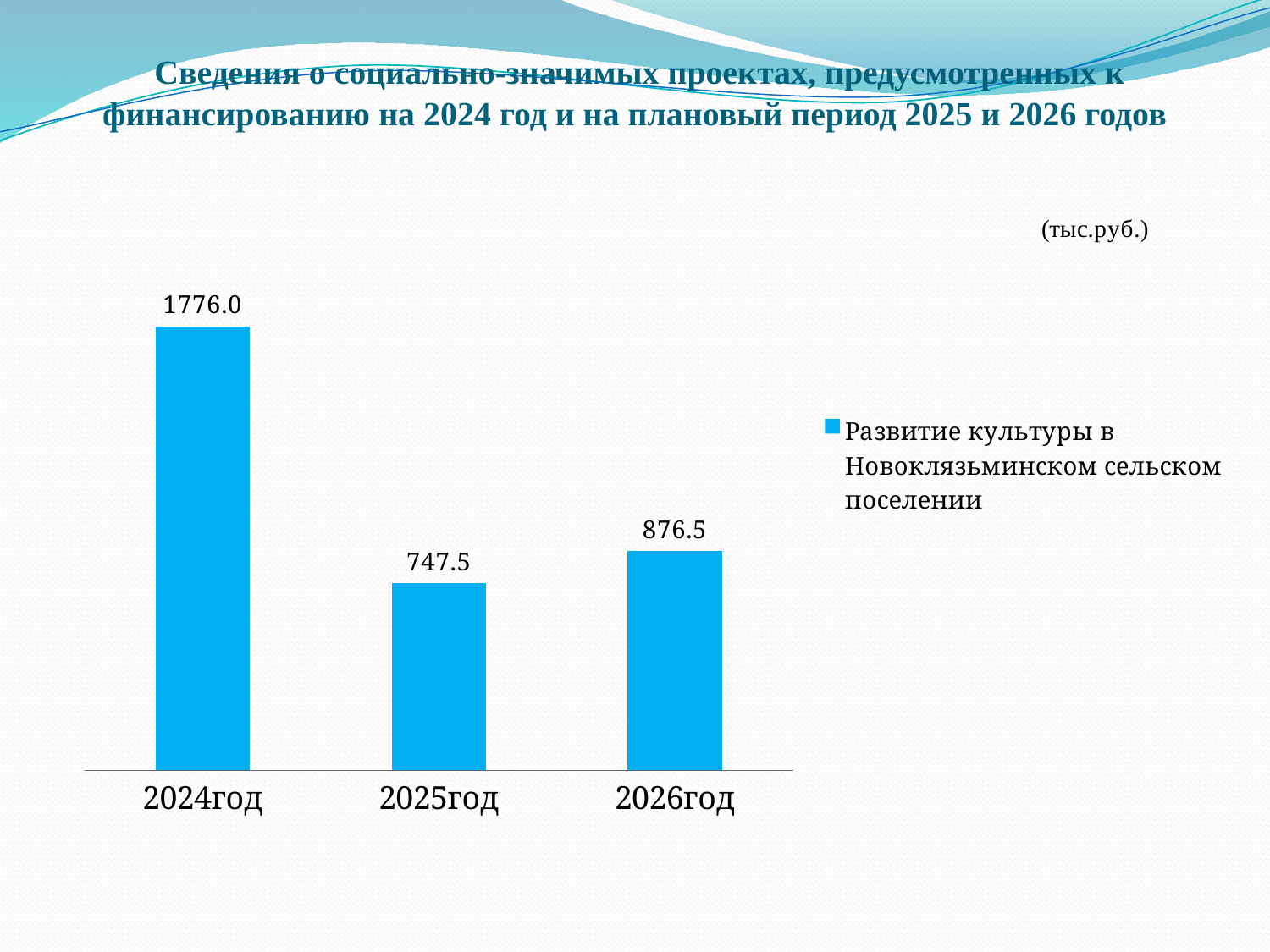
Which is larger, the value for 2025год or 2026год? 2026год How many years are shown on the x axis? 3 Which year has the highest value? 2024год What is the value for 2026год? 876.5 What kind of chart is shown on the slide? bar chart What is the value for 2024год? 1776.0 What is the value for 2025год? 747.5 What is the difference between the values for 2026год and 2025год? 129.0 What series name is shown in the legend? Развитие культуры в Новоклязьминском сельском поселении What is the difference between the values for 2024год and 2025год? 1028.5 Which year has the lowest value? 2025год How many series does the legend list? 1